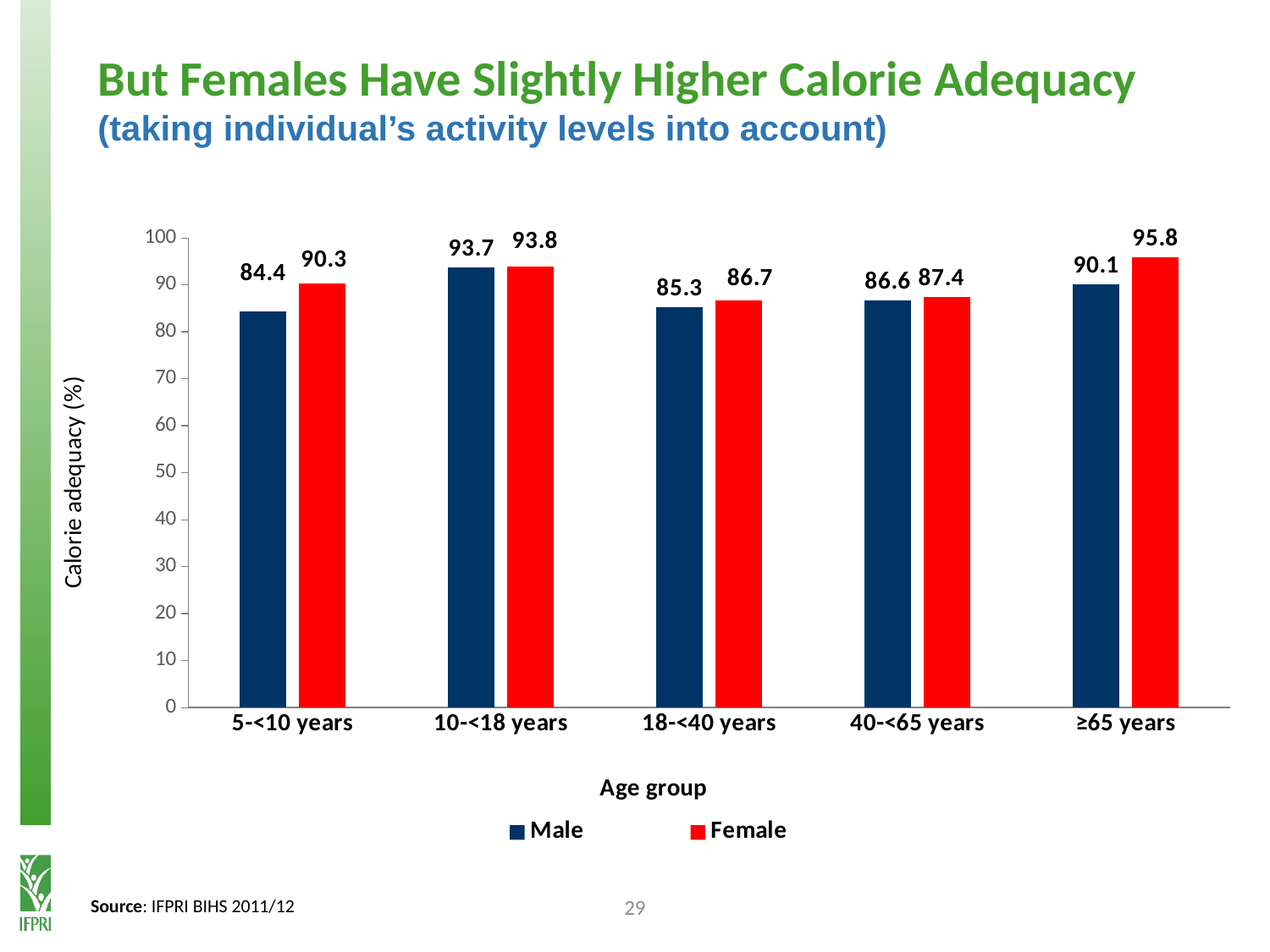
How many series does the legend list? 2 What colour represents the Female series in the chart? Red What is the calorie adequacy for females aged ≥65 years? 95.8 Which age group has the lowest calorie adequacy for males? 5-<10 years What kind of chart is shown on the slide? Bar chart What is the calorie adequacy for females aged 18-<40 years? 86.7 Which is larger: male calorie adequacy for 10-<18 years or male calorie adequacy for 40-<65 years? 10-<18 years What is the difference between female and male calorie adequacy in the ≥65 years age group? 5.7 How many age groups are shown on the x axis? 5 What is the calorie adequacy for males aged 5-<10 years? 84.4 Which age group has the highest calorie adequacy for females? ≥65 years What is the difference between female and male calorie adequacy in the 5-<10 years age group? 5.9